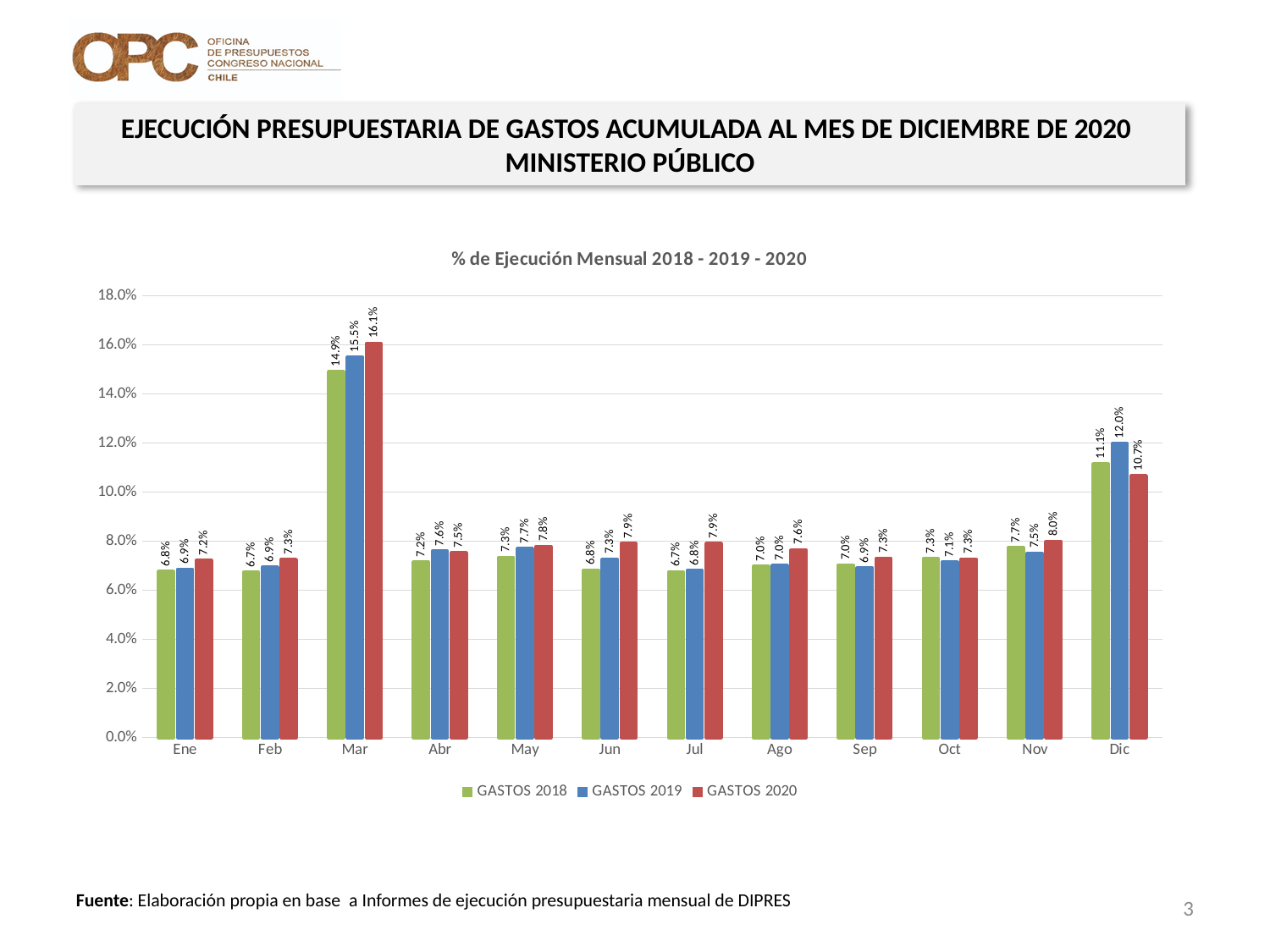
How many series does the legend list? 3 What is the value for GASTOS 2019 in Jun? 7.3% What is the title of the chart? % de Ejecución Mensual 2018 - 2019 - 2020 What is the value for GASTOS 2020 in Mar? 16.1% Which month has the lowest value for GASTOS 2020? Ene What is the difference between GASTOS 2019 and GASTOS 2018 in Dic? 0.9% Which month has the highest value for GASTOS 2019? Mar Which is larger in Dic: GASTOS 2019 or GASTOS 2020? GASTOS 2019 What kind of chart is shown on the slide? bar chart How many months are shown on the x axis? 12 Is the value for GASTOS 2018 in Mar greater or less than 14.0%? greater What is the value for GASTOS 2018 in Dic? 11.1%